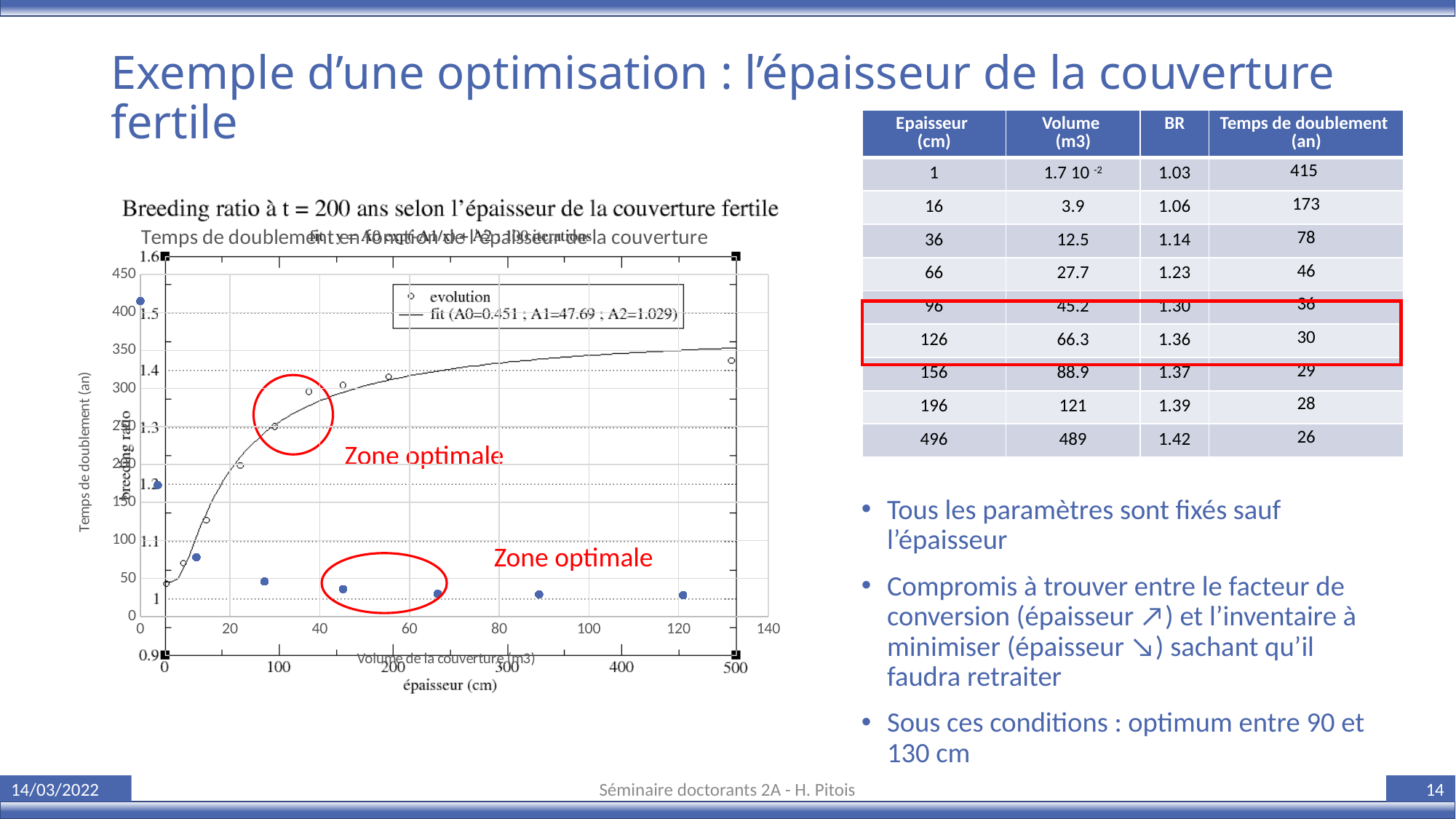
On the chart titled 'Temps de doublement en fonction de l'épaisseur de la couverture', does the temps de doublement rise or fall as the volume increases? fall On the chart titled 'Breeding ratio à t = 200 ans selon l'épaisseur de la couverture fertile', does the breeding ratio rise or fall as épaisseur increases? rise On the chart titled 'Breeding ratio à t = 200 ans selon l'épaisseur de la couverture fertile', is the breeding ratio at épaisseur 200 cm greater or less than 1.3? greater On the chart titled 'Temps de doublement en fonction de l'épaisseur de la couverture', is the temps de doublement at the smallest volume greater or less than 400? greater On the chart titled 'Temps de doublement en fonction de l'épaisseur de la couverture', how many blue data points are plotted? 8 On the chart titled 'Temps de doublement en fonction de l'épaisseur de la couverture', is the temps de doublement at a volume of about 45 m3 greater or less than 100? less On the chart titled 'Temps de doublement en fonction de l'épaisseur de la couverture', what kind of chart is it? scatter chart On the chart titled 'Breeding ratio à t = 200 ans selon l'épaisseur de la couverture fertile', what are the two legend entries? evolution and fit On the chart titled 'Breeding ratio à t = 200 ans selon l'épaisseur de la couverture fertile', what value of A1 is given in the legend for the fit? 47.69 On the chart titled 'Breeding ratio à t = 200 ans selon l'épaisseur de la couverture fertile', what is the label of the x axis? épaisseur (cm) On the chart titled 'Breeding ratio à t = 200 ans selon l'épaisseur de la couverture fertile', how many series does the legend list? 2